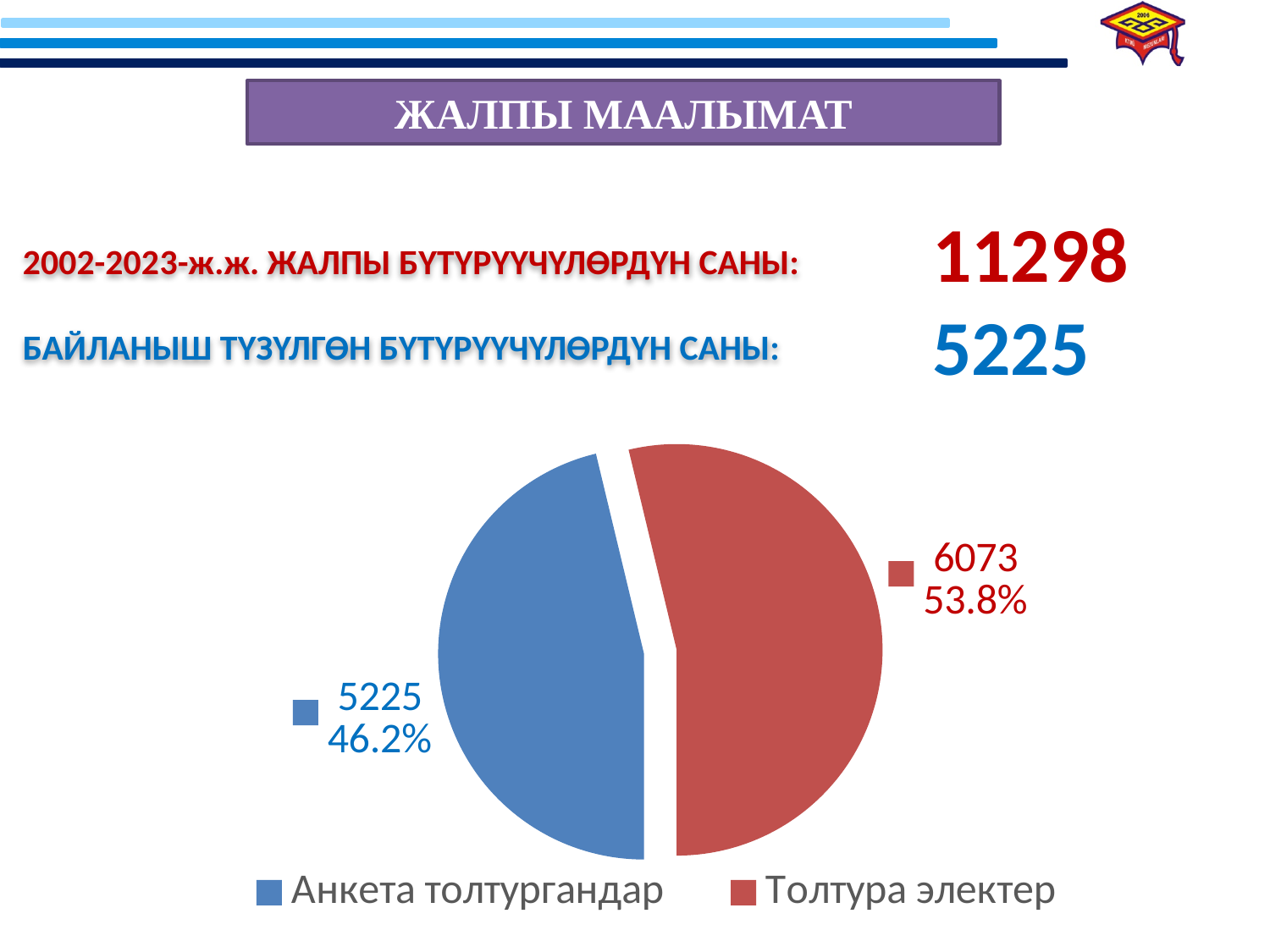
What is the value for Анкета толтургандар? 5225 What colour is the slice for Анкета толтургандар? blue What percentage share does Анкета толтургандар have in the pie chart? 46.2% Which is larger, Анкета толтургандар or Толтура электер? Толтура электер What is the total of the two values shown in the pie chart? 11298 Which slice of the pie chart is the largest? Толтура электер Which slice of the pie chart is the smallest? Анкета толтургандар What percentage share does Толтура электер have in the pie chart? 53.8% What is the difference between the values for Толтура электер and Анкета толтургандар? 848 How many slices does the pie chart have? 2 What is the value for Толтура электер? 6073 What kind of chart is shown on the slide? pie chart